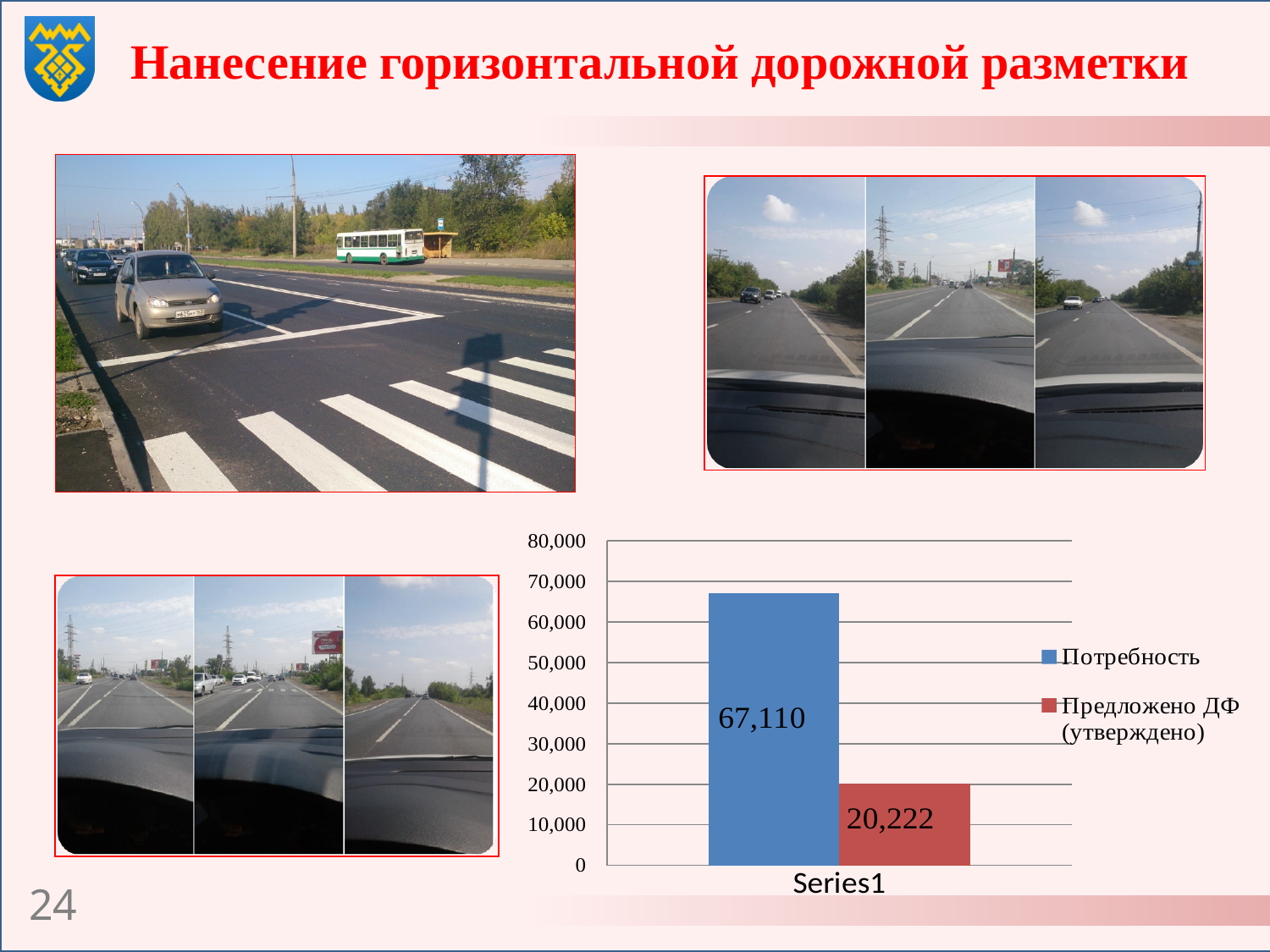
What kind of chart is shown on the slide? bar chart What is the category label shown on the x axis of the chart? Series1 Which series has the higher value in the chart? Потребность Which series has the lower value in the chart? Предложено ДФ (утверждено) Is the value for Предложено ДФ (утверждено) greater or less than 30,000? less Is the Потребность value larger or smaller than the Предложено ДФ (утверждено) value? larger What is the value of the Предложено ДФ (утверждено) bar in the chart? 20,222 What is the value of the Потребность bar in the chart? 67,110 How many series does the chart legend list? 2 What is the difference between the Потребность value and the Предложено ДФ (утверждено) value? 46,888 What is the maximum value shown on the chart's vertical axis? 80,000 Is the value for Потребность greater or less than 60,000? greater